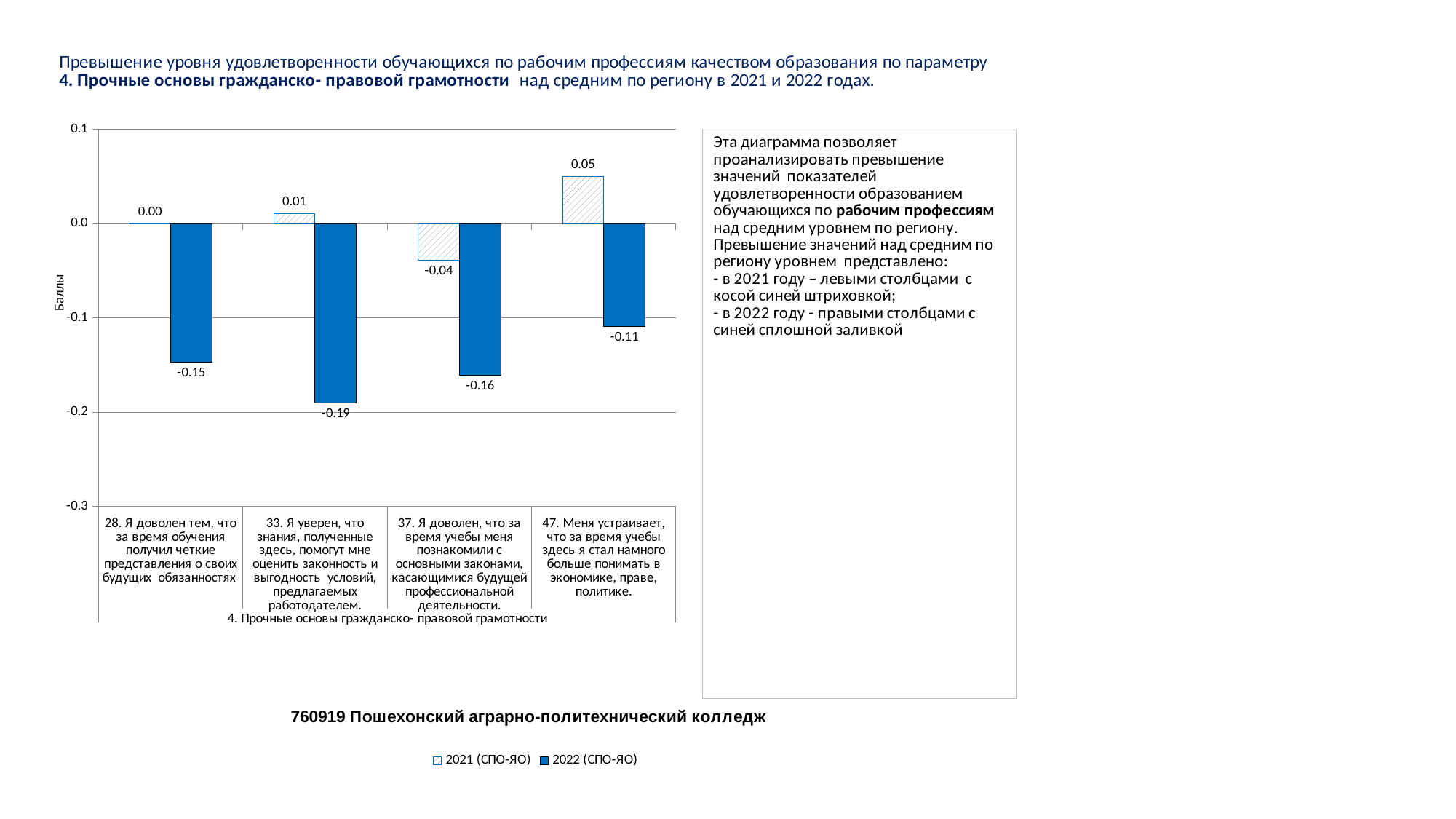
How many categories are shown on the x axis of the chart? 4 What is the label of the vertical axis of the chart? Баллы How many series does the legend list? 2 What is the value for 2022 (СПО-ЯО) for category 33 (Я уверен, что знания, полученные здесь, помогут мне оценить законность и выгодность условий, предлагаемых работодателем)? -0.19 Which category has the lowest value for the 2022 (СПО-ЯО) series? 33. Я уверен, что знания, полученные здесь, помогут мне оценить законность и выгодность условий, предлагаемых работодателем. Is the 2022 (СПО-ЯО) value for category 37 greater or less than -0.1? less Which category has the highest value for the 2021 (СПО-ЯО) series? 47. Меня устраивает, что за время учебы здесь я стал намного больше понимать в экономике, праве, политике. What is the difference between the 2021 (СПО-ЯО) and 2022 (СПО-ЯО) values for category 28 (Я доволен тем, что за время обучения получил четкие представления о своих будущих обязанностях)? 0.15 Which is larger for category 47: the 2021 (СПО-ЯО) value or the 2022 (СПО-ЯО) value? 2021 (СПО-ЯО) What is the value for 2021 (СПО-ЯО) for category 47 (Меня устраивает, что за время учебы здесь я стал намного больше понимать в экономике, праве, политике)? 0.05 What type of chart is shown on the slide? bar chart What is the value for 2021 (СПО-ЯО) for category 37 (Я доволен, что за время учебы меня познакомили с основными законами, касающимися будущей профессиональной деятельности)? -0.04